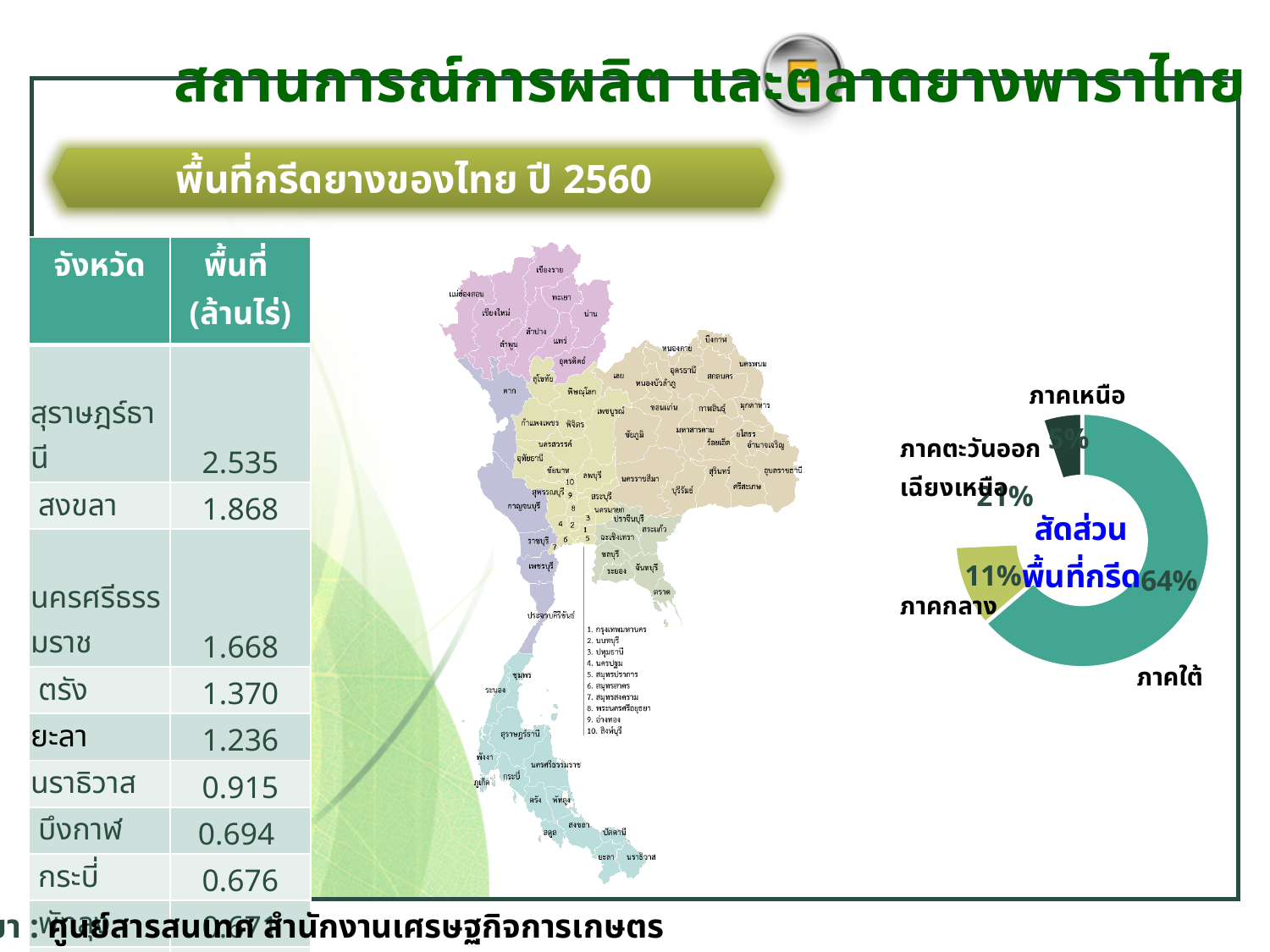
Is the share of ภาคใต้ in the doughnut chart greater or less than 50%? greater In the doughnut chart, which has the larger share: ภาคกลาง or ภาคตะวันออกเฉียงเหนือ? ภาคตะวันออกเฉียงเหนือ In the doughnut chart, how many percentage points larger is the share of ภาคใต้ than that of ภาคตะวันออกเฉียงเหนือ? 43 percentage points In the doughnut chart, what share is shown for ภาคกลาง? 11% What kind of chart is used to show the regional shares on the slide? doughnut chart How many regions are shown in the doughnut chart? 4 In the doughnut chart, how many percentage points larger is the share of ภาคตะวันออกเฉียงเหนือ than that of ภาคกลาง? 10 percentage points In the doughnut chart, what share is shown for ภาคใต้? 64% What text appears in the centre of the doughnut chart? สัดส่วนพื้นที่กรีด Which region has the largest share in the doughnut chart? ภาคใต้ In the doughnut chart, what share is shown for ภาคตะวันออกเฉียงเหนือ? 21% Which region has the smallest share in the doughnut chart? ภาคเหนือ